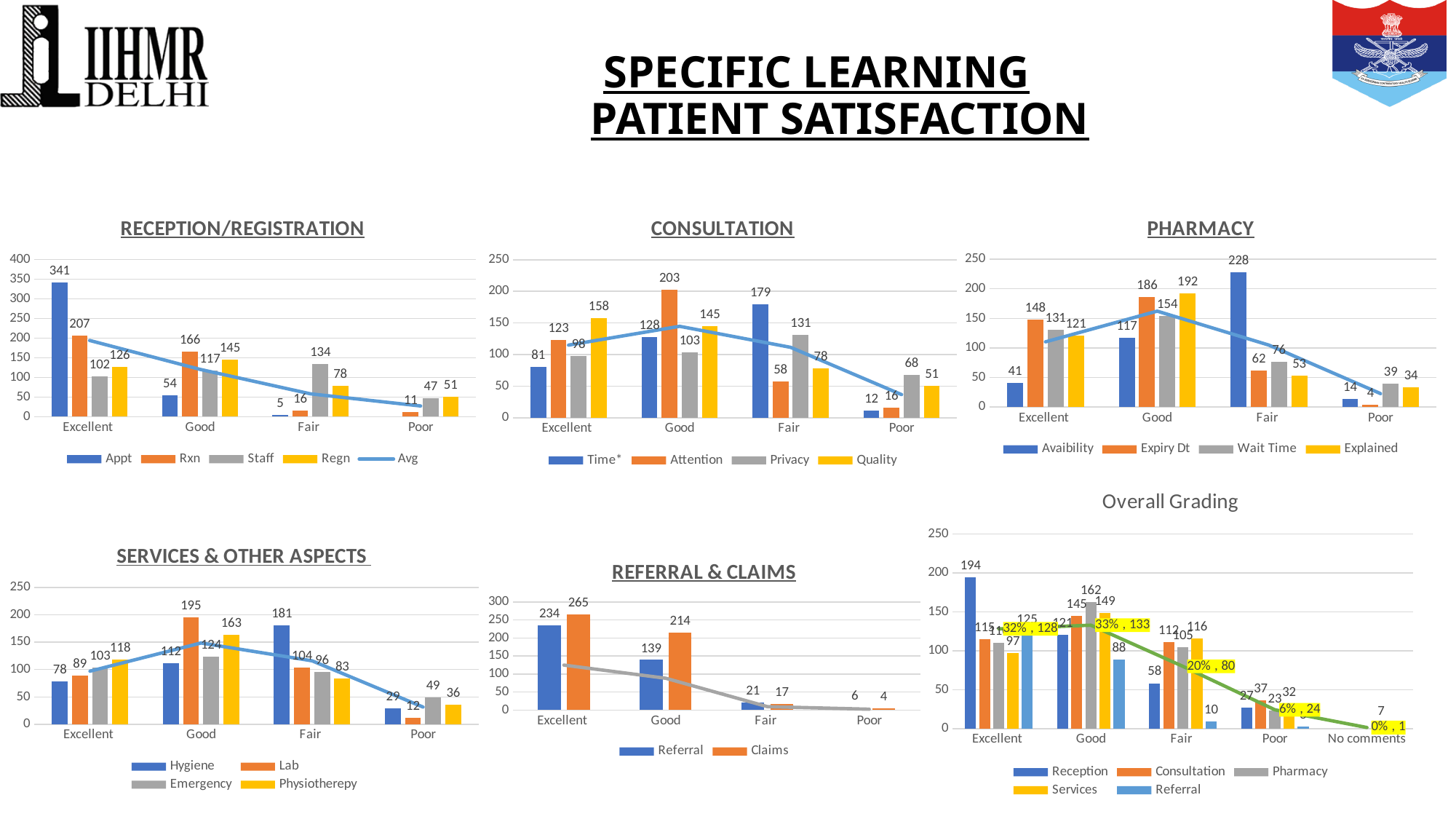
In the SERVICES & OTHER ASPECTS chart, what is the value for Hygiene in the Fair category? 181 In the SERVICES & OTHER ASPECTS chart, which series has the lowest value in the Poor category? Lab In the RECEPTION/REGISTRATION chart, what is the value for Appt in the Excellent category? 341 In the RECEPTION/REGISTRATION chart, how many series does the legend list? 5 In the REFERRAL & CLAIMS chart, what is the difference between Claims and Referral in the Good category? 75 In the CONSULTATION chart, what is the value for Attention in the Good category? 203 In the Overall Grading chart, how many categories are shown on the x axis? 5 In the Overall Grading chart, what is the value for Reception in the Excellent category? 194 In the PHARMACY chart, what is the difference between Explained and Expiry Dt in the Good category? 6 In the REFERRAL & CLAIMS chart, which is larger in the Excellent category, Referral or Claims? Claims In the PHARMACY chart, what is the value for Avaibility in the Fair category? 228 In the CONSULTATION chart, which series has the highest value in the Fair category? Time*